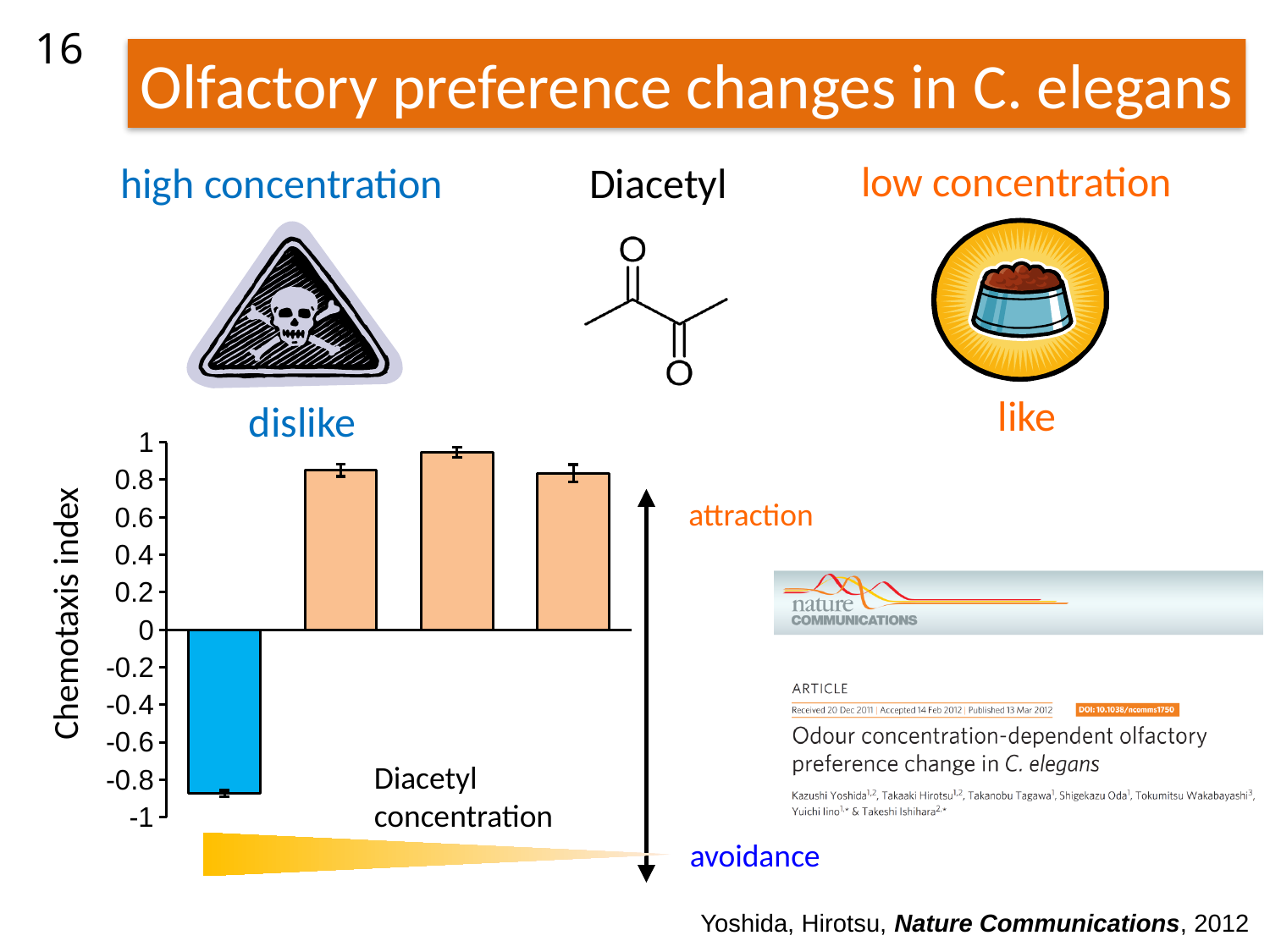
What colour is the leftmost bar in the chart? blue What kind of chart is shown on the slide? bar chart Which bar has the lowest chemotaxis index? the leftmost bar What are the minimum and maximum values shown on the y axis of the chart? -1 and 1 Is the chemotaxis index for the leftmost bar greater or less than -0.6? less How many bars are plotted in the chart? 4 Which bar has the highest chemotaxis index? the third bar from the left Is the chemotaxis index for the second bar from the left greater or less than 0.6? greater What is the label of the y axis of the chart? Chemotaxis index Is the chemotaxis index for the third bar from the left greater or less than 0.8? greater How many bars in the chart have a negative chemotaxis index? 1 Which is larger, the chemotaxis index of the leftmost bar or of the rightmost bar? the rightmost bar